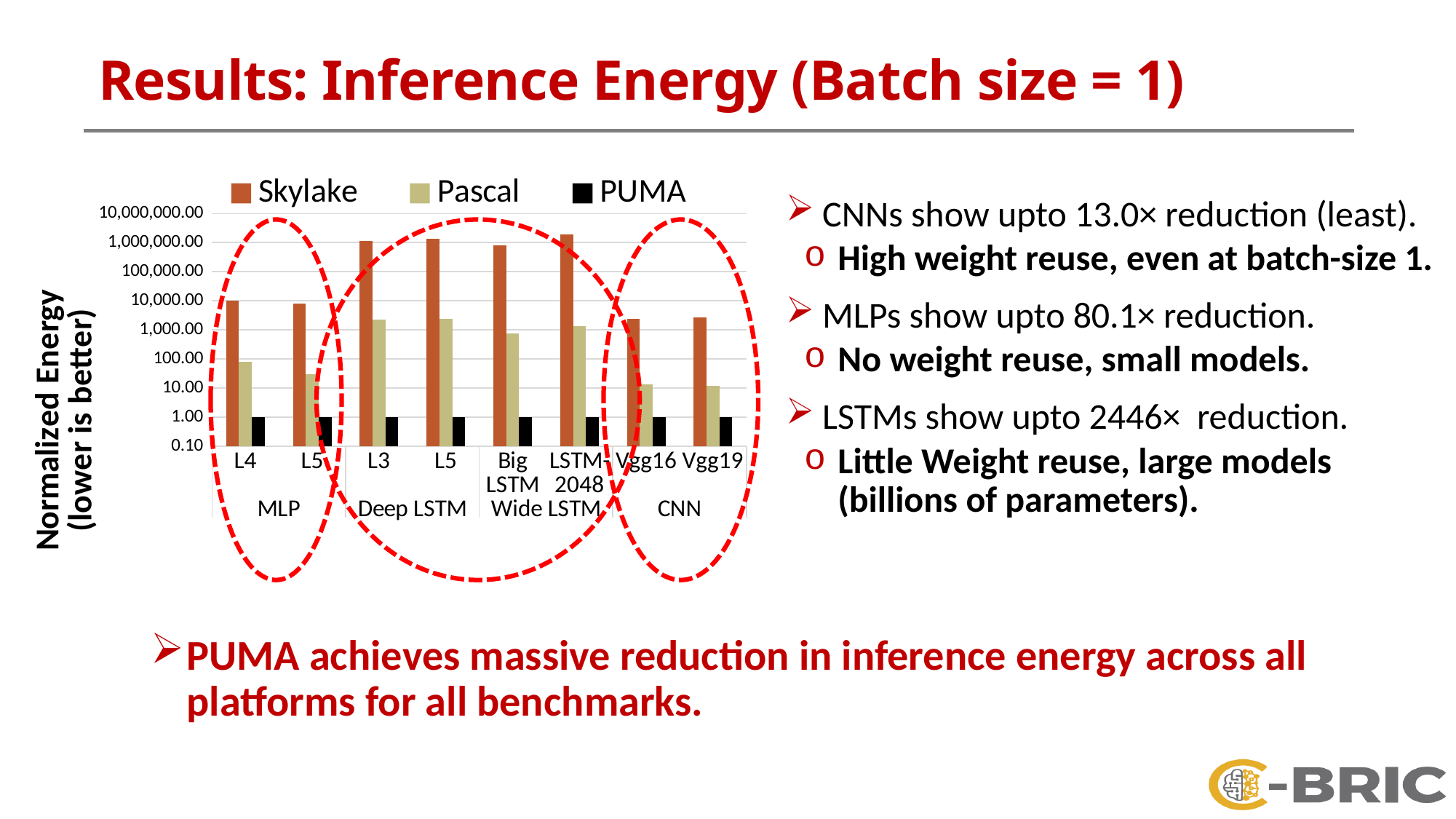
Which benchmark has the highest Skylake value? LSTM-2048 Which is larger, the Skylake value for L4 (MLP) or the Skylake value for Vgg16? L4 (MLP) What kind of chart is shown on the slide? bar chart Which series are listed in the chart legend? Skylake, Pascal, PUMA How many series does the chart legend list? 3 What is the y-axis label of the chart? Normalized Energy (lower is better) Is the Pascal value for L3 (Deep LSTM) greater or less than 1,000.00? greater Is the Skylake value for LSTM-2048 greater or less than 1,000,000.00? greater How many benchmark categories are plotted along the x axis? 8 Which is larger, the Pascal value for L4 (MLP) or the Pascal value for L5 (MLP)? L4 (MLP)